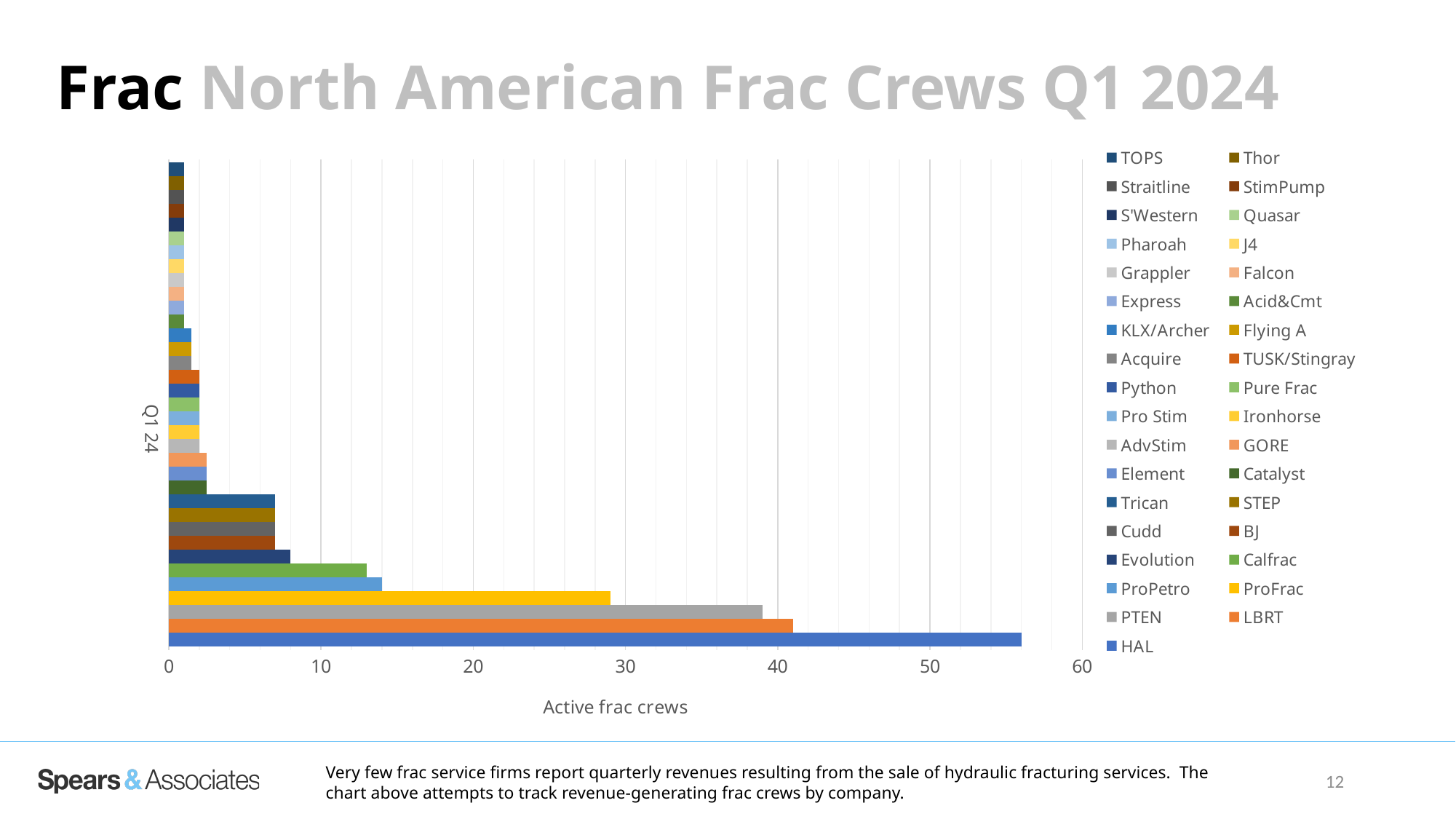
Is the value for HAL greater or less than 50? greater Is the value for ProFrac greater or less than 20? greater Which has more active frac crews, ProFrac or ProPetro? ProFrac Is the value for LBRT greater or less than 30? greater What is the title of the horizontal axis? Active frac crews Which has more active frac crews, HAL or LBRT? HAL What is the label of the single category on the vertical axis? Q1 24 Which company has the highest number of active frac crews? HAL What kind of chart is shown on the slide? bar chart How many series does the legend list? 35